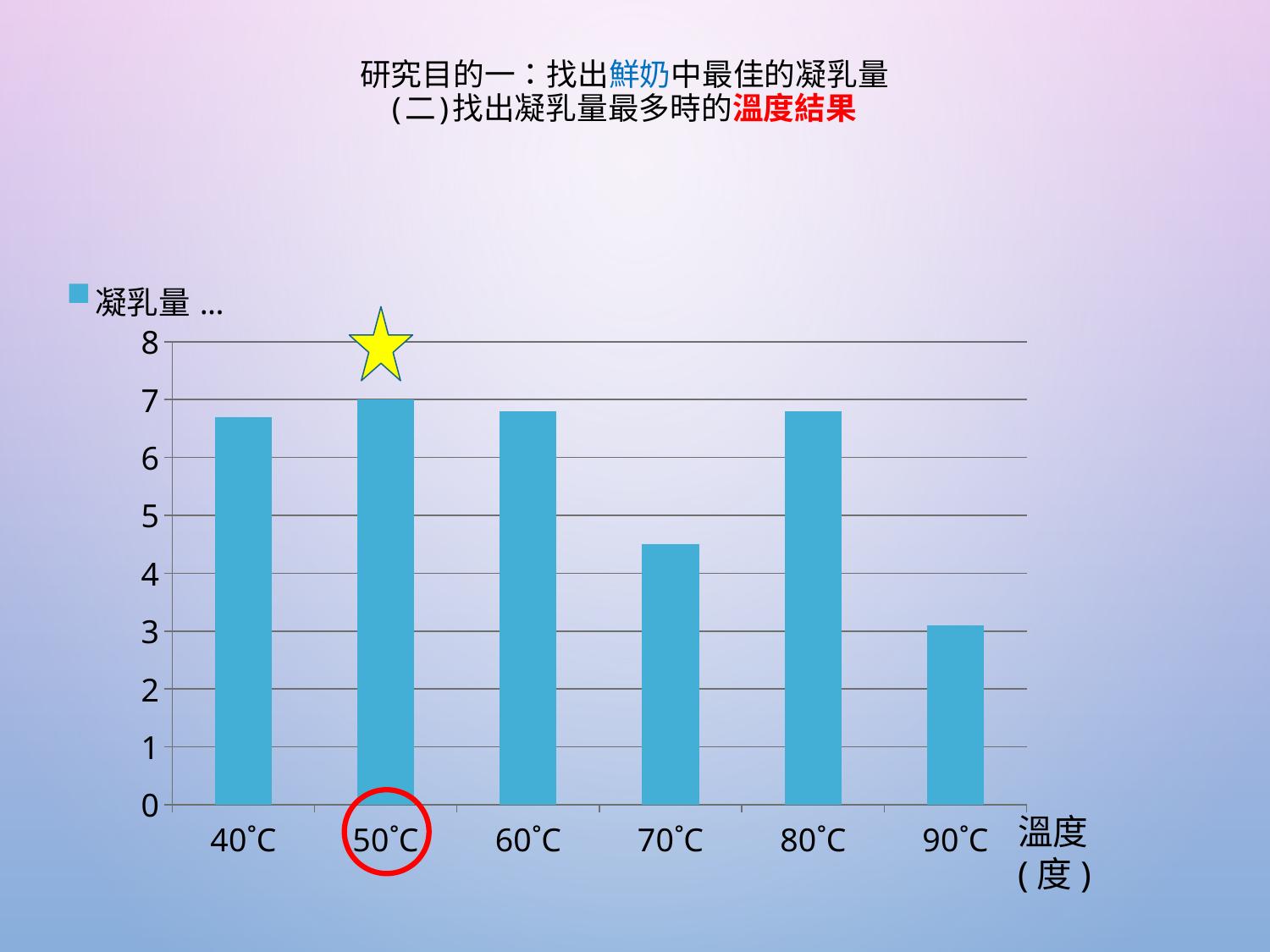
Which is larger, the value for 70˚C or the value for 90˚C? 70˚C What is the label of the x axis? 溫度(度) What is the value of the bar for 50˚C? 7 Is the value for 40˚C greater or less than 6? greater How many series does the legend list? 1 What kind of chart is shown on the slide? bar chart Is the value for 70˚C greater or less than 5? less Which is larger, the value for 40˚C or the value for 70˚C? 40˚C Which temperature has the lowest bar? 90˚C Which temperature has the highest bar? 50˚C How many temperature categories are plotted on the x axis? 6